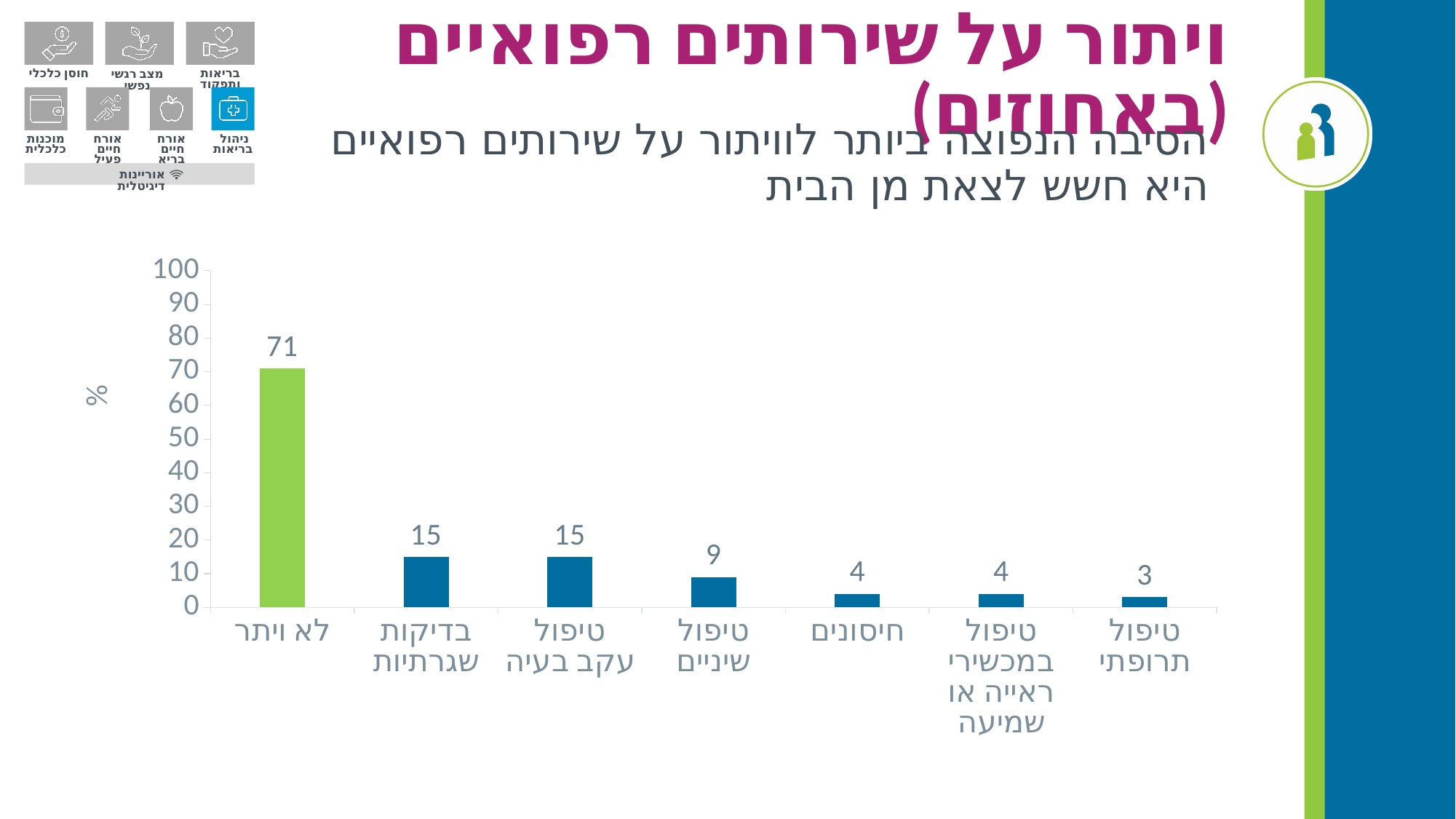
What is the value for "טיפול תרופתי"? 3 Is the value for "לא ויתר" greater or less than 50? greater What kind of chart is shown on the slide? bar chart What is the label on the vertical axis? % How many categories are shown on the x axis? 7 What is the value for "טיפול שיניים"? 9 Which category has the highest value? לא ויתר Which is larger, the value for "טיפול שיניים" or the value for "חיסונים"? טיפול שיניים What is the difference between the values for "לא ויתר" and "בדיקות שגרתיות"? 56 What is the value for "לא ויתר"? 71 What is the value for "חיסונים"? 4 Which category has the lowest value? טיפול תרופתי